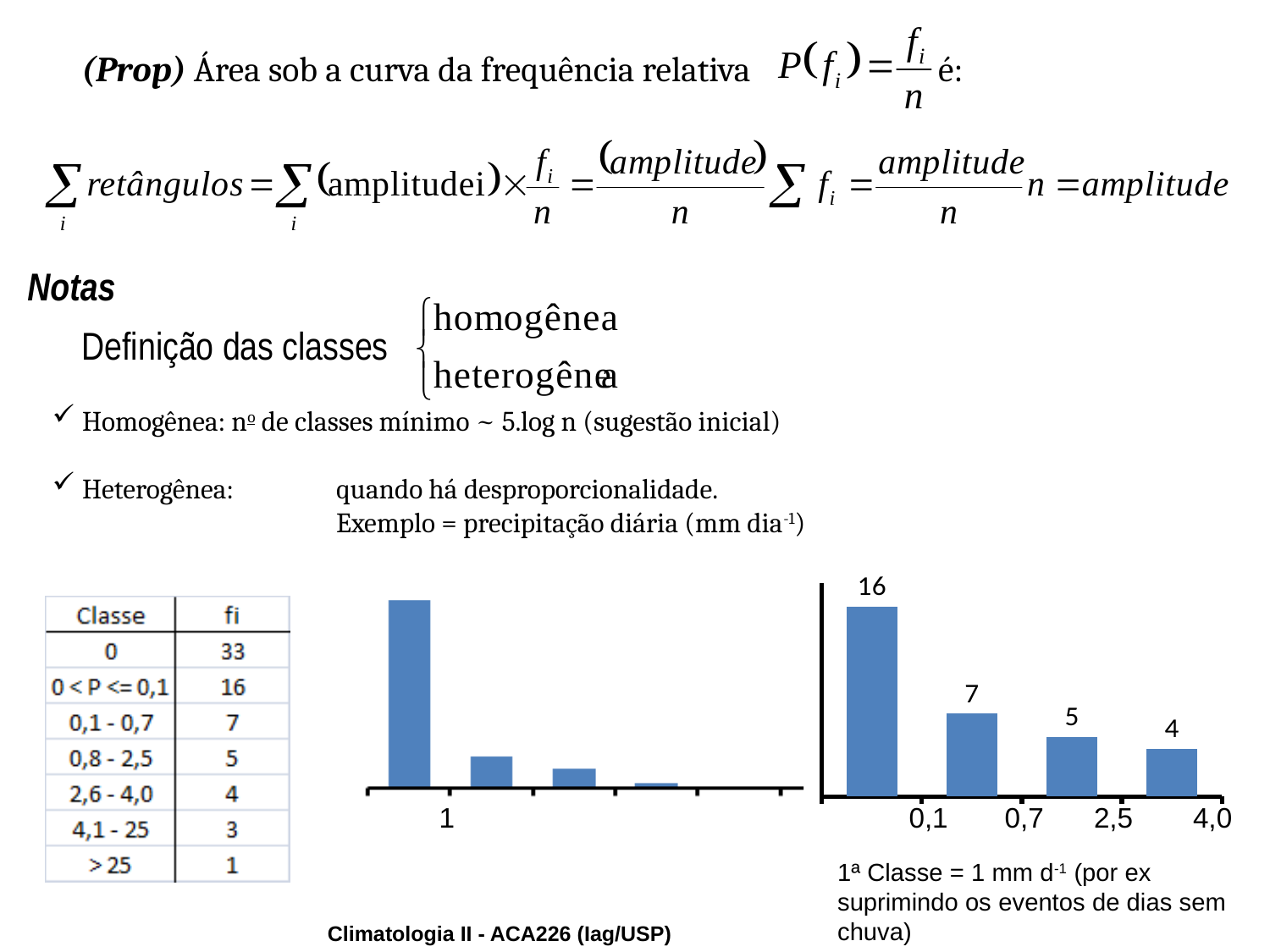
What type of chart is the chart in the middle of the slide (with the axis label 1)? bar chart In the right-hand bar chart, do the values rise or fall from left to right? fall In the right-hand bar chart, which is larger: the third bar or the fourth bar? the third bar (5) How many bars does the middle bar chart (with the axis label 1) have? 4 In the right-hand bar chart, what is the value of the second bar? 7 In the right-hand bar chart, what is the value of the third bar? 5 In the right-hand bar chart, what is the lowest value shown? 4 How many bars does the right-hand bar chart have? 4 In the right-hand bar chart, what is the value of the last bar, next to the 4,0 axis label? 4 In the right-hand bar chart, what is the highest value shown? 16 In the right-hand bar chart, what is the value of the first (tallest) bar? 16 In the right-hand bar chart, what is the difference between the first bar (16) and the second bar (7)? 9